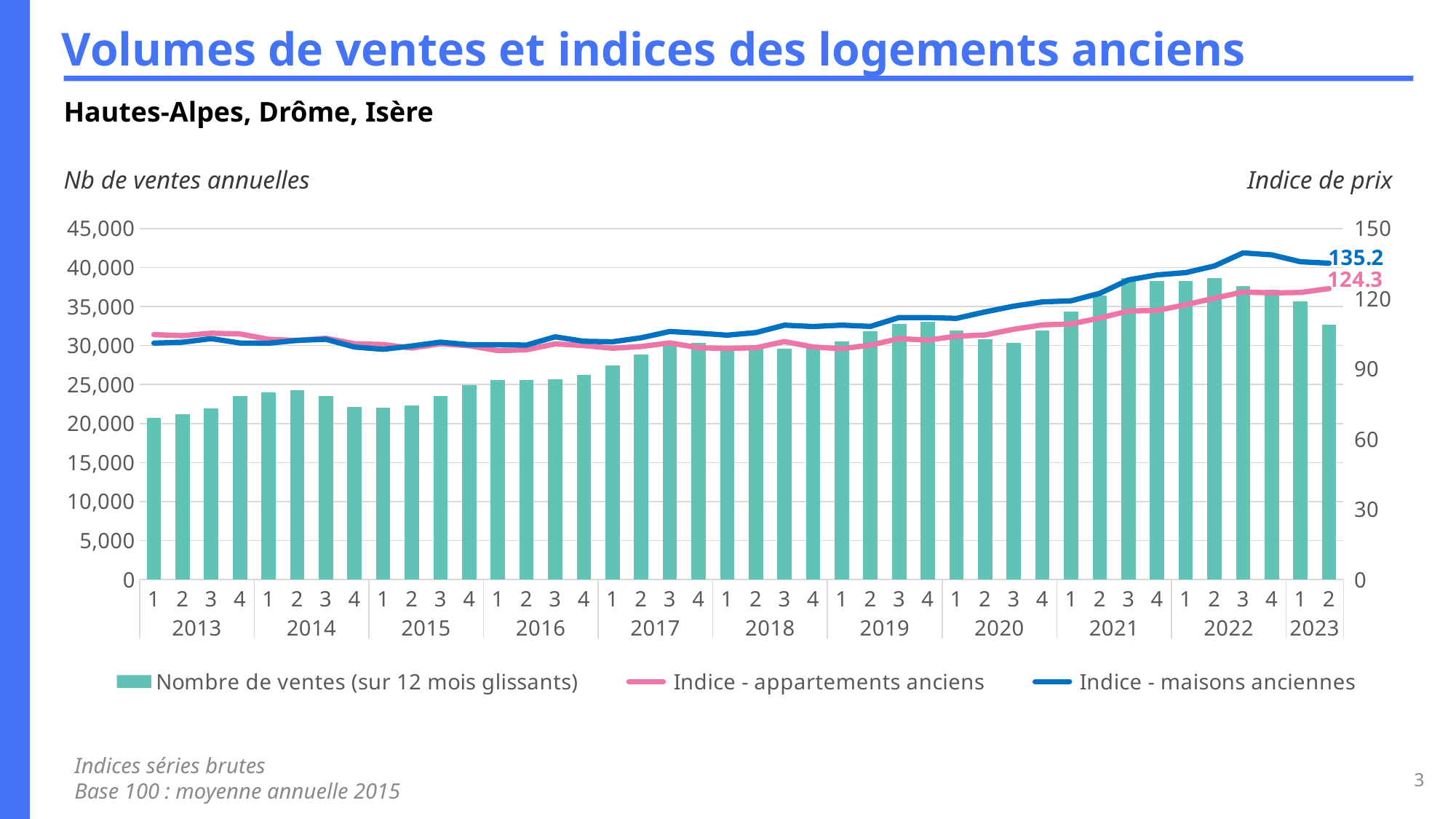
Which quarter has the lowest Nombre de ventes bar? Quarter 1 of 2013 How many years are shown along the x axis? 11 What kind of chart is shown on the slide? Combined bar and line chart What is the value of the Indice - appartements anciens series at the last point (2023, quarter 2)? 124.3 What is the difference between the Indice - maisons anciennes and the Indice - appartements anciens at the last point (2023, quarter 2)? 10.9 At the last point (2023, quarter 2), which index is higher: Indice - maisons anciennes or Indice - appartements anciens? Indice - maisons anciennes Is the Nombre de ventes value for quarter 2 of 2022 greater or less than 35,000? greater Is the Nombre de ventes value for quarter 1 of 2013 greater or less than 25,000? less What is the value of the Indice - maisons anciennes series at the last point (2023, quarter 2)? 135.2 How many series does the legend list? 3 Does the Indice - maisons anciennes series rise or fall between 2019 and quarter 3 of 2022? rise Is the Indice - maisons anciennes value for quarter 1 of 2013 greater or less than 120? less